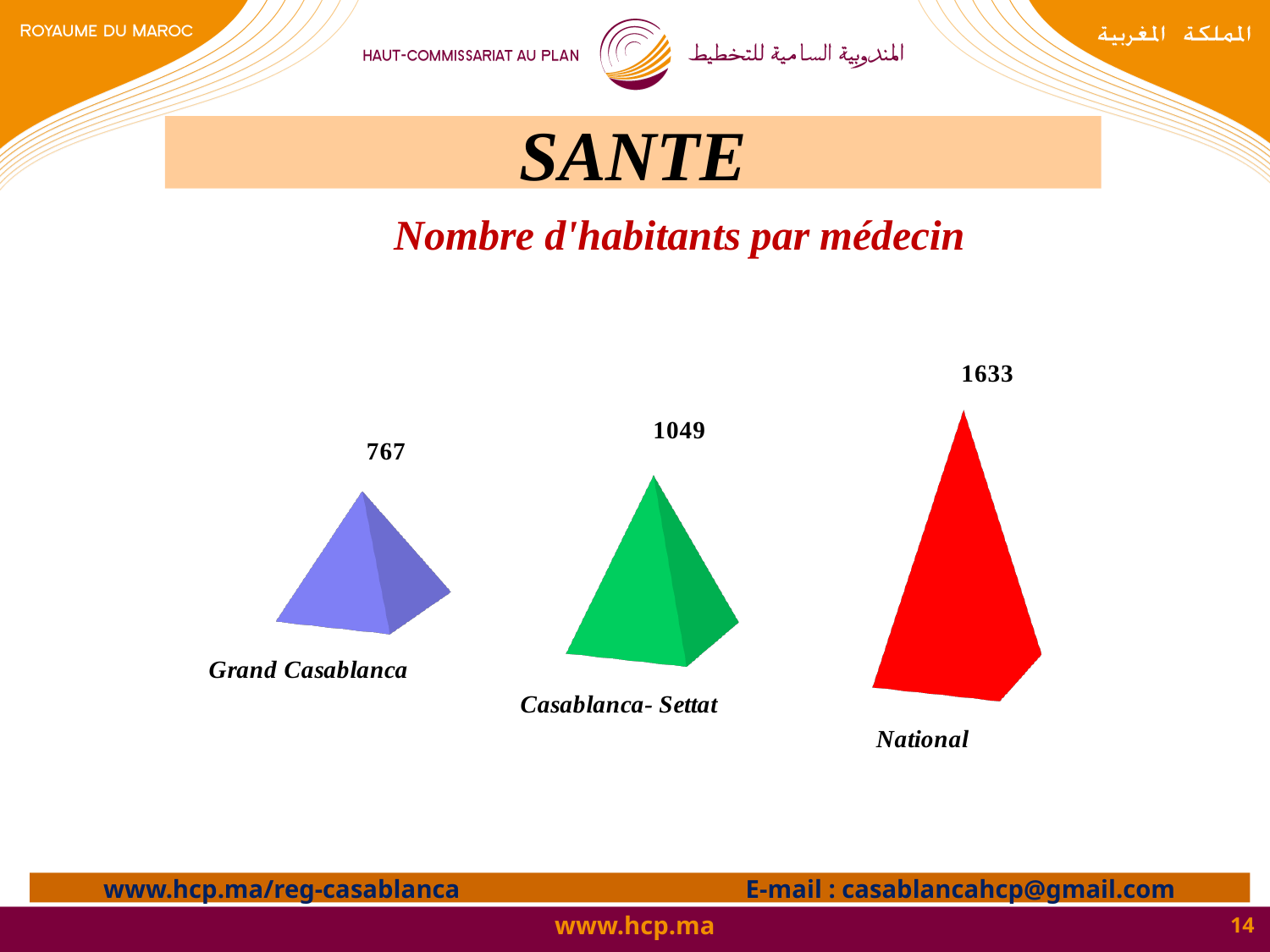
What is the number of inhabitants per doctor for Grand Casablanca? 767 Do the values rise or fall from left to right across the chart? rise Which category has the highest number of inhabitants per doctor? National What is the difference between the Casablanca-Settat value and the Grand Casablanca value? 282 What is the number of inhabitants per doctor at the National level? 1633 Which is larger, the value for Grand Casablanca or the value for Casablanca-Settat? Casablanca-Settat What is the title of the chart? Nombre d'habitants par médecin What is the difference between the National value and the Casablanca-Settat value? 584 What is the difference between the National value and the Grand Casablanca value? 866 How many categories are shown in the chart? 3 Which category has the lowest number of inhabitants per doctor? Grand Casablanca What is the number of inhabitants per doctor for Casablanca-Settat? 1049